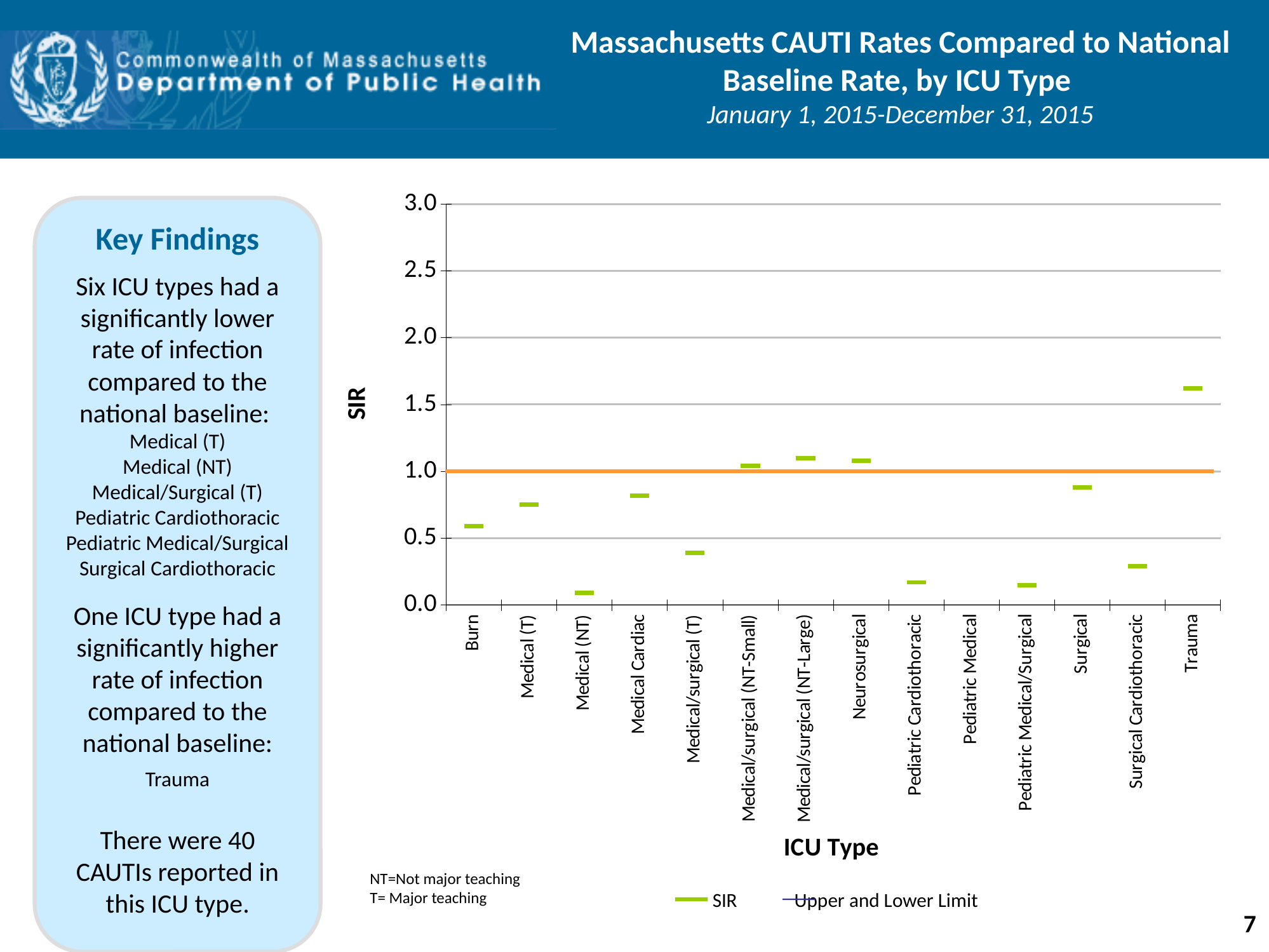
Is the SIR value for Trauma greater or less than 1.5? greater How many series does the chart legend list? 2 Which has the larger SIR, Burn or Medical (T)? Medical (T) Is the SIR value for Burn greater or less than 1.0? less What are the two entries listed in the chart legend? SIR; Upper and Lower Limit Which has the larger SIR, Medical/surgical (T) or Medical Cardiac? Medical Cardiac How many ICU types are listed along the x axis of the chart? 14 Is the SIR value for Medical (NT) greater or less than 0.5? less Which ICU type has the highest SIR on the chart? Trauma What is the label on the y axis of the chart? SIR